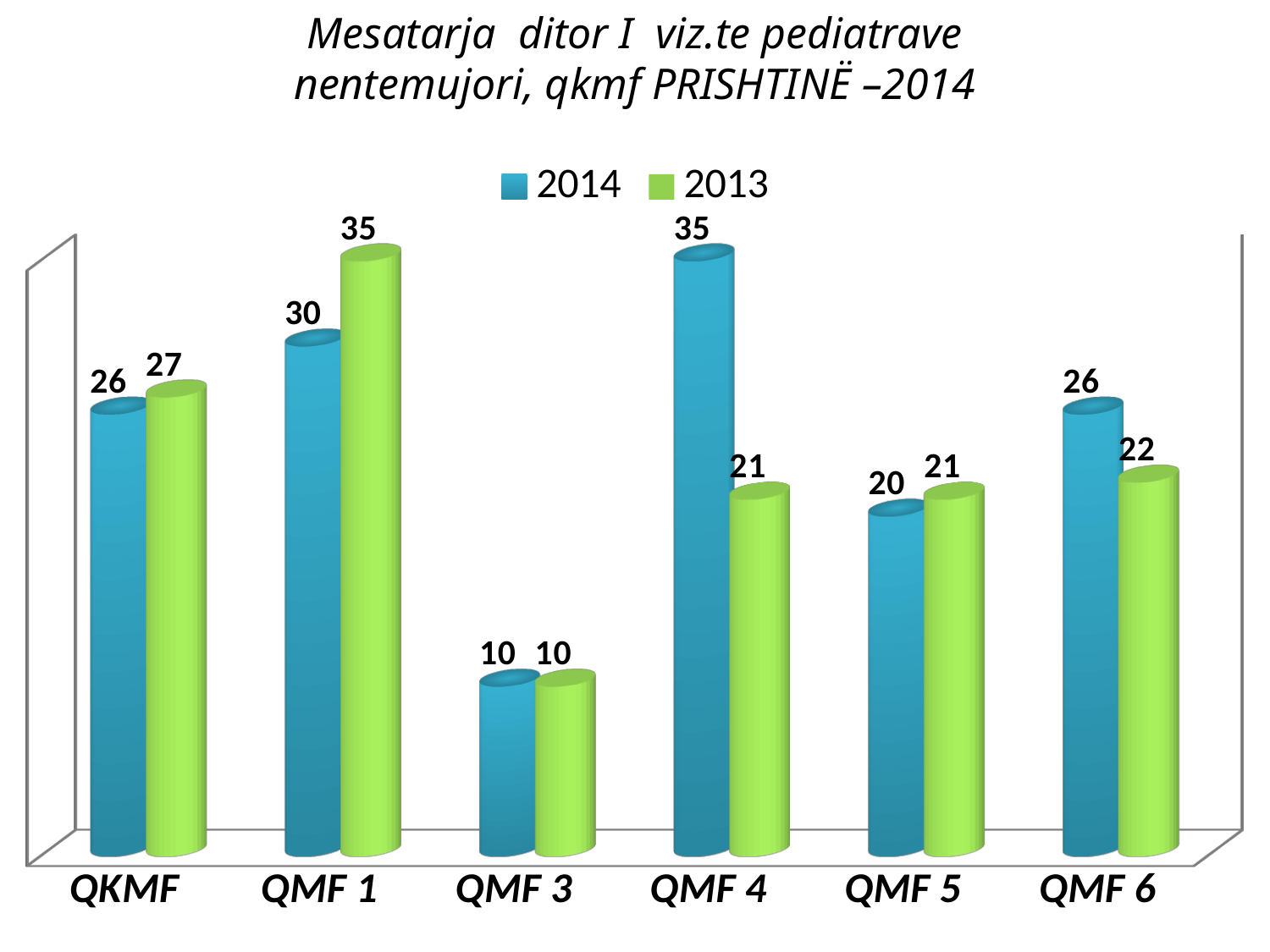
What is the difference between the 2014 and 2013 values for QMF 4? 14 What is the 2013 value for QKMF? 27 How many series does the legend list? 2 Which colour represents the 2013 series? Green Which is larger for QMF 6, the 2014 value or the 2013 value? 2014 What is the difference between the 2013 and 2014 values for QMF 1? 5 What is the 2014 value for QMF 4? 35 Which category has the lowest 2014 value? QMF 3 What is the 2014 value for QMF 5? 20 How many categories are shown on the x axis? 6 What kind of chart is shown on the slide? Bar chart Which category has the highest 2013 value? QMF 1